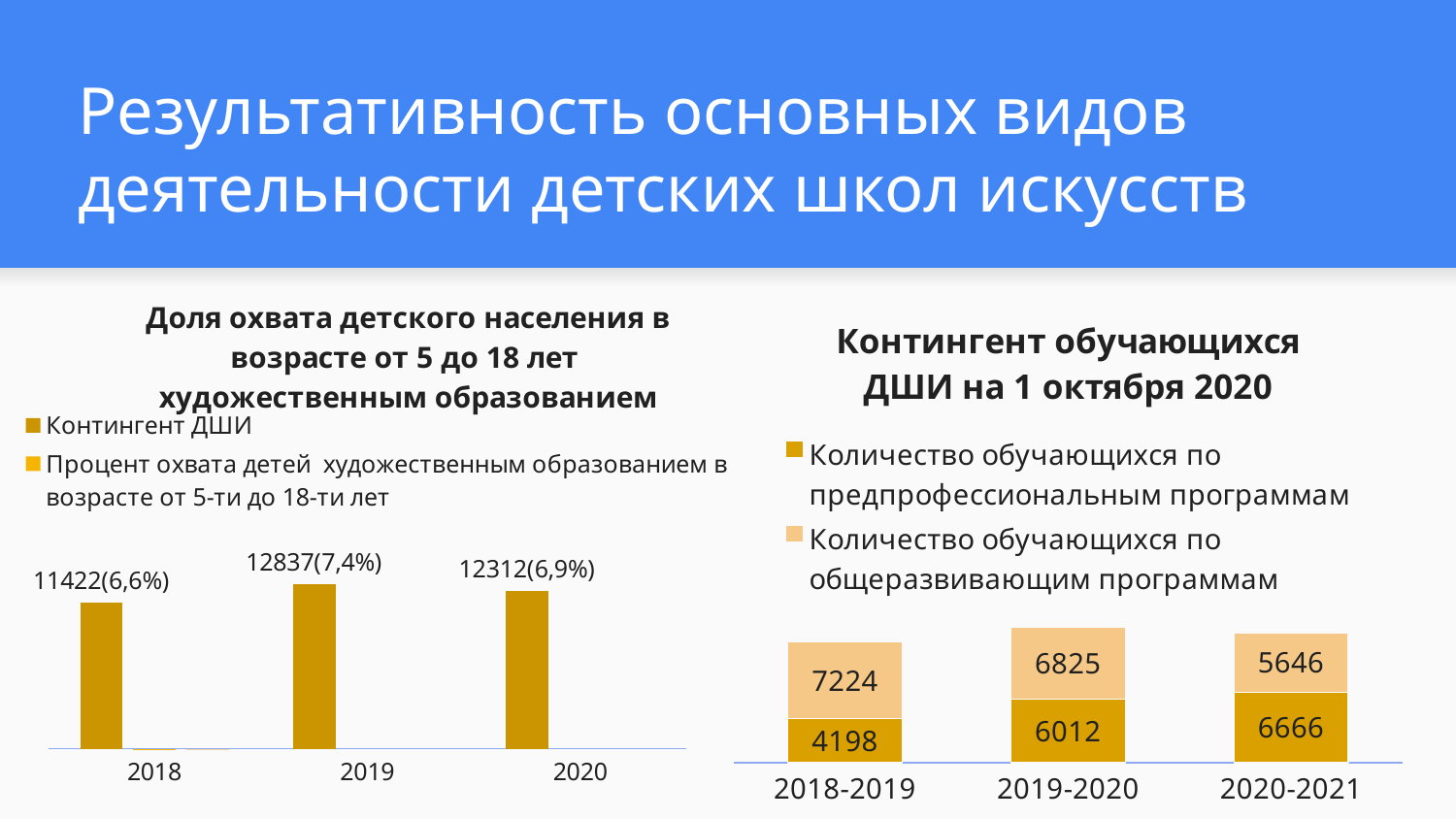
In the chart 'Контингент обучающихся ДШИ на 1 октября 2020', what is the difference between the two series in 2020-2021? 1020 In the left chart 'Доля охвата детского населения в возрасте от 5 до 18 лет художественным образованием', how many years are shown on the x axis? 3 In the chart 'Контингент обучающихся ДШИ на 1 октября 2020', how many series does the legend list? 2 What kind of chart is the chart 'Контингент обучающихся ДШИ на 1 октября 2020'? stacked bar chart In the chart 'Контингент обучающихся ДШИ на 1 октября 2020', does the value for 'Количество обучающихся по предпрофессиональным программам' rise or fall from 2018-2019 to 2020-2021? rise In the left chart 'Доля охвата детского населения в возрасте от 5 до 18 лет художественным образованием', what is the data label for 2019? 12837(7,4%) In the chart 'Контингент обучающихся ДШИ на 1 октября 2020', what is the value for 'Количество обучающихся по предпрофессиональным программам' in 2018-2019? 4198 In the left chart 'Доля охвата детского населения в возрасте от 5 до 18 лет художественным образованием', which year has the lowest 'Контингент ДШИ'? 2018 In the chart 'Контингент обучающихся ДШИ на 1 октября 2020', which period has the highest value for 'Количество обучающихся по общеразвивающим программам'? 2018-2019 In the chart 'Контингент обучающихся ДШИ на 1 октября 2020', what is the total of the stacked bar for 2019-2020? 12837 In the chart 'Контингент обучающихся ДШИ на 1 октября 2020', which period has the lowest value for 'Количество обучающихся по предпрофессиональным программам'? 2018-2019 In the chart 'Контингент обучающихся ДШИ на 1 октября 2020', what is the value for 'Количество обучающихся по общеразвивающим программам' in 2020-2021? 5646